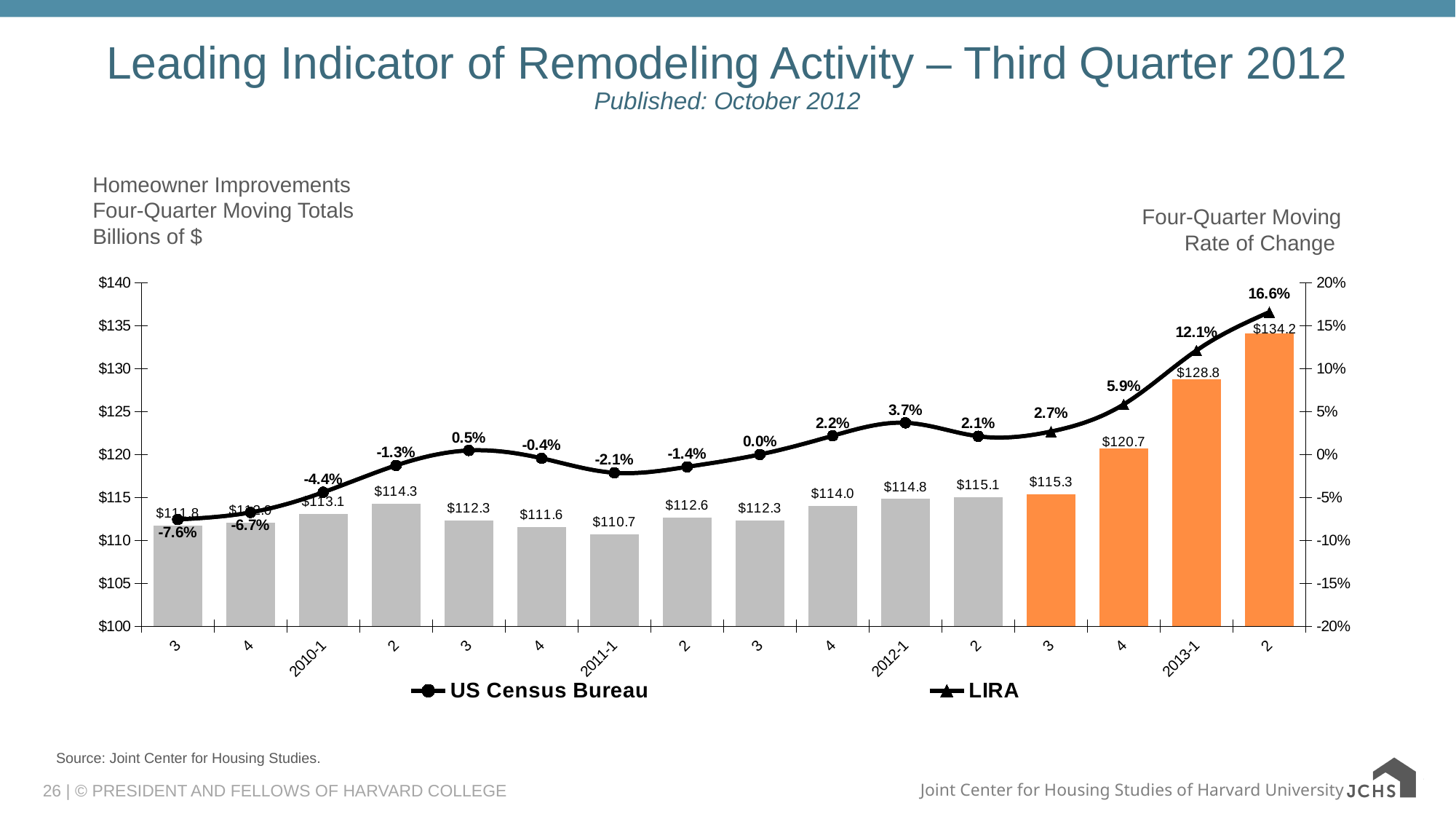
What is the four-quarter moving total for 2011-1? $110.7 What is the four-quarter moving total for 2013-1? $128.8 Which period has the lowest four-quarter moving total? 2011-1 How many bars are plotted in the chart? 16 What are the two series named in the legend? US Census Bureau and LIRA What is the highest rate of change shown on the line? 16.6% How many series does the legend list? 2 Which is larger, the four-quarter moving total for 2010-1 or for 2011-1? 2010-1 Which period has the highest four-quarter moving total? 2013 quarter 2 (the last bar) What is the rate of change shown for 2010-1? -4.4% What is the difference between the four-quarter moving totals for 2013-1 and 2012-1? $14.0 What is the four-quarter moving rate of change for 2012-1? 3.7%